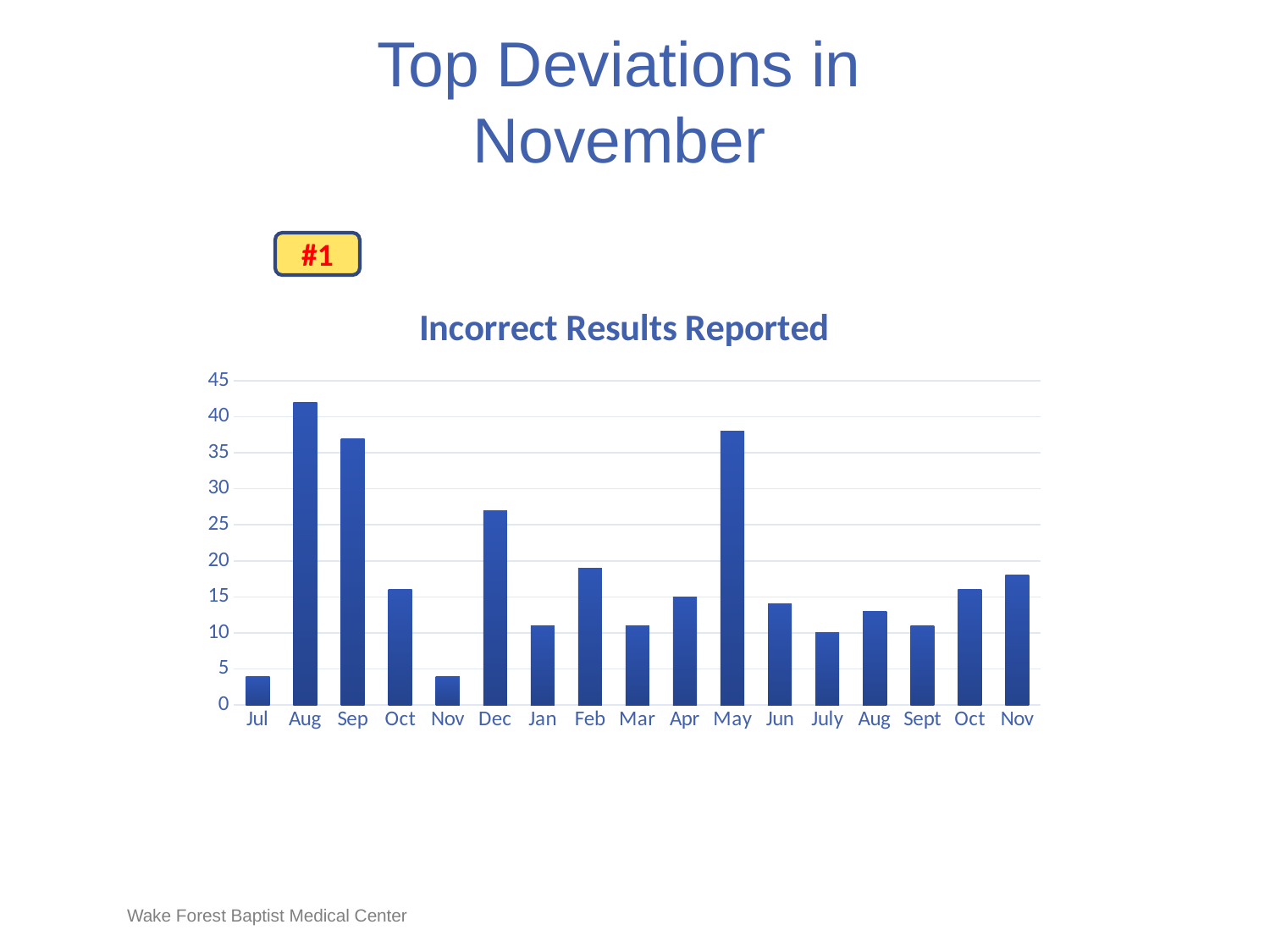
Which month has the highest value in the chart? Aug (the first Aug) Which is larger, the value for the first Aug or the value for Sep? Aug Is the value for Jan greater or less than 15? less How many months are shown along the x axis of the chart? 17 Is the value for Sep greater or less than 35? greater Is the value for Dec greater or less than 25? greater What is the title of the chart? Incorrect Results Reported What is the highest value shown on the vertical axis of the chart? 45 What type of chart is shown on the slide? bar chart Which is larger, the value for Dec or the value for Feb? Dec